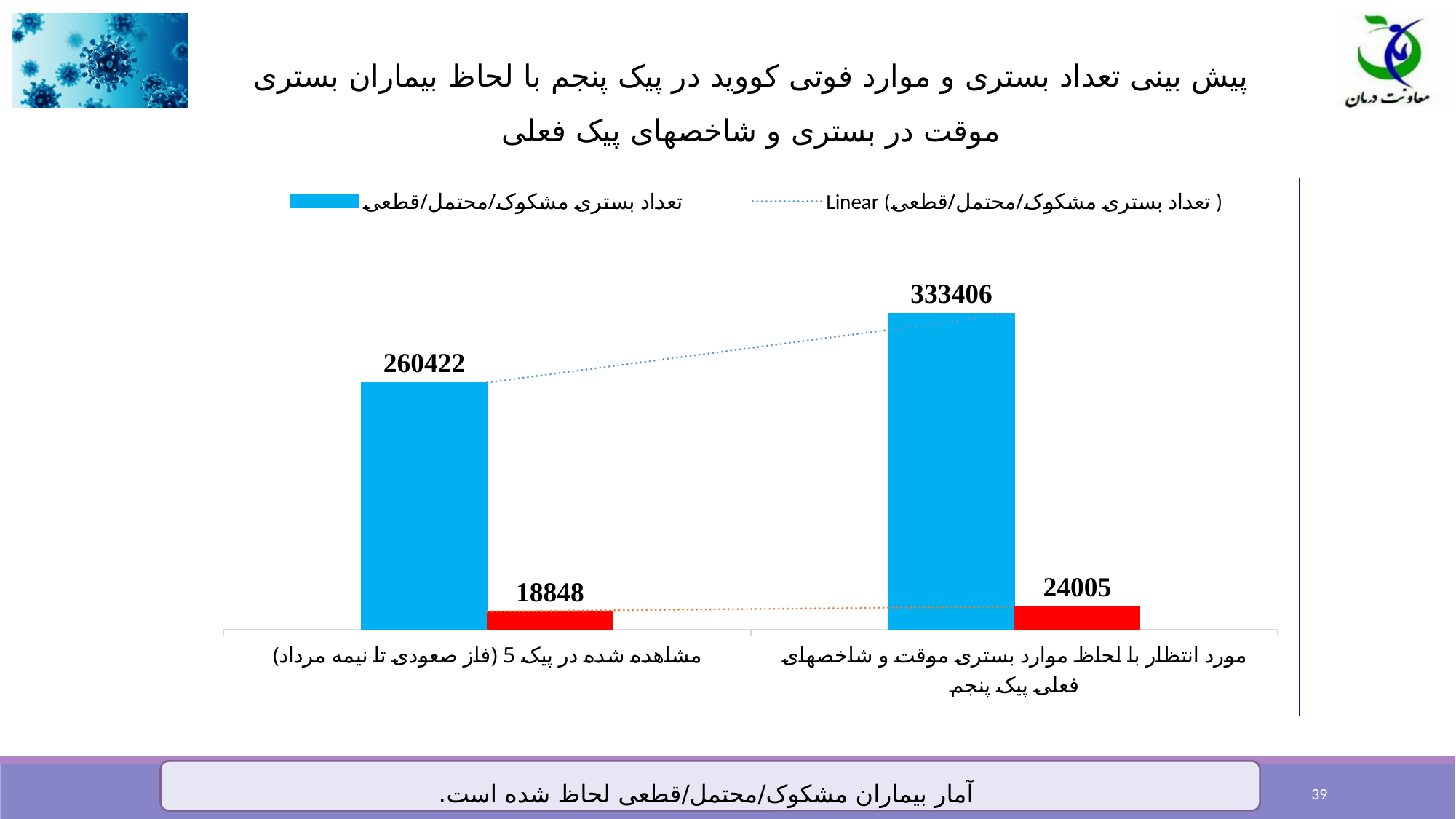
How many categories are shown on the x axis of the chart? 2 What is the value of the blue bar for the category 'مورد انتظار با لحاظ موارد بستری موقت و شاخصهای فعلی پیک پنجم'? 333406 What is the value of the red bar for the category 'مشاهده شده در پیک 5 (فاز صعودی تا نیمه مرداد)'? 18848 What is the difference between the two red bar values (24005 and 18848)? 5157 How many entries does the chart legend list? 2 What is the value of the blue bar for the category 'مشاهده شده در پیک 5 (فاز صعودی تا نیمه مرداد)'? 260422 What type of chart is shown on the slide? bar chart Is the red bar value for the observed peak 5 category (18848) larger or smaller than the red bar value for the expected category (24005)? smaller What is the value of the red bar for the category 'مورد انتظار با لحاظ موارد بستری موقت و شاخصهای فعلی پیک پنجم'? 24005 Which category has the lower red bar value? مشاهده شده در پیک 5 (فاز صعودی تا نیمه مرداد) What is the difference between the two blue bar values (333406 and 260422)? 72984 Which category has the higher blue bar value? مورد انتظار با لحاظ موارد بستری موقت و شاخصهای فعلی پیک پنجم